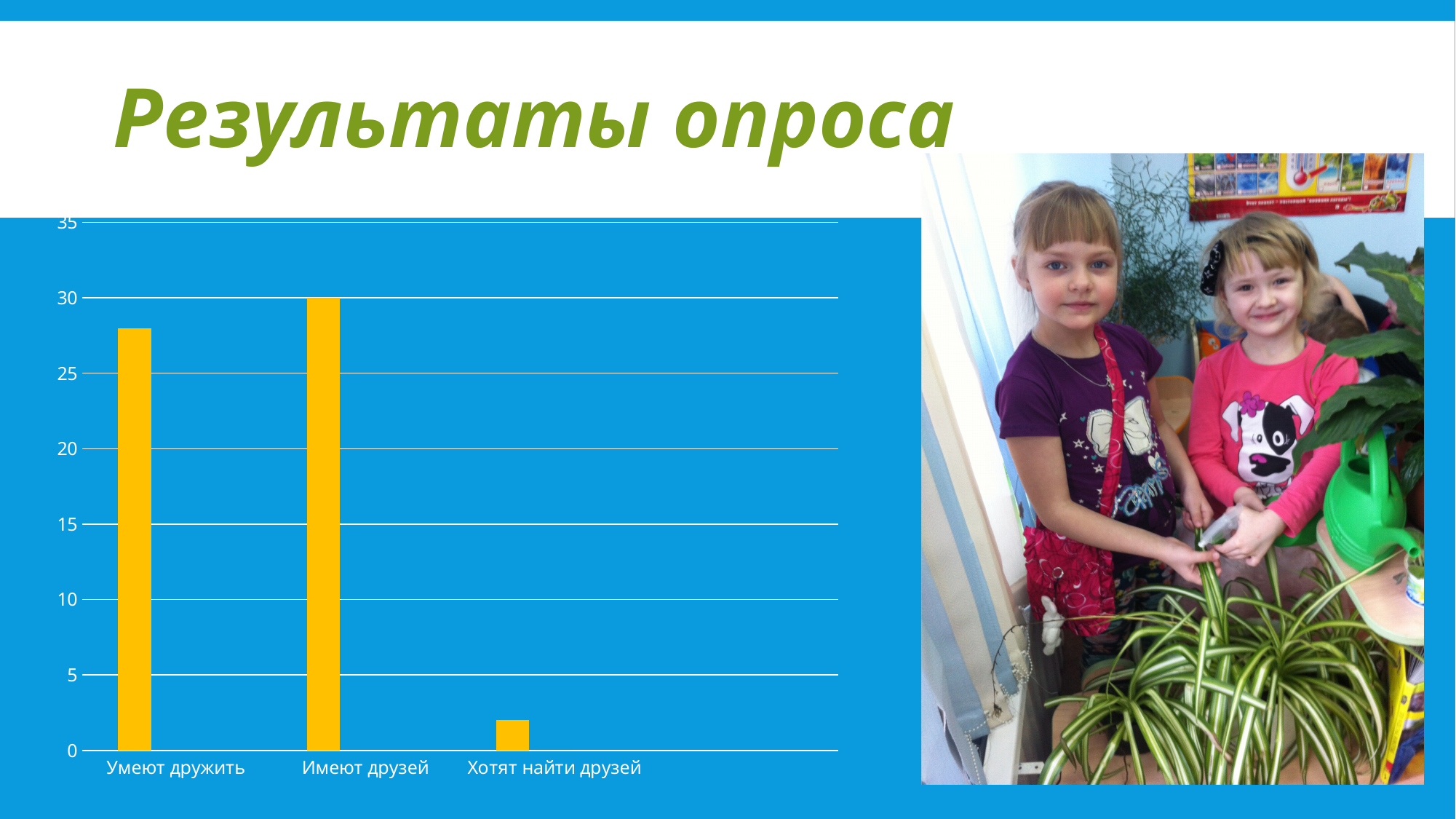
Is the value for Умеют дружить greater or less than 30? less Which is larger, the value for Имеют друзей or the value for Умеют дружить? Имеют друзей Which is larger, the value for Умеют дружить or the value for Хотят найти друзей? Умеют дружить Which category has the lowest bar? Хотят найти друзей Which category has the highest bar? Имеют друзей Is the value for Умеют дружить greater or less than 25? greater What kind of chart is shown on the slide? bar chart What is the highest tick value shown on the vertical axis? 35 Is the value for Хотят найти друзей greater or less than 5? less What colour are the bars in the chart? yellow What is the value for Имеют друзей? 30 How many categories are shown on the x axis of the chart? 3